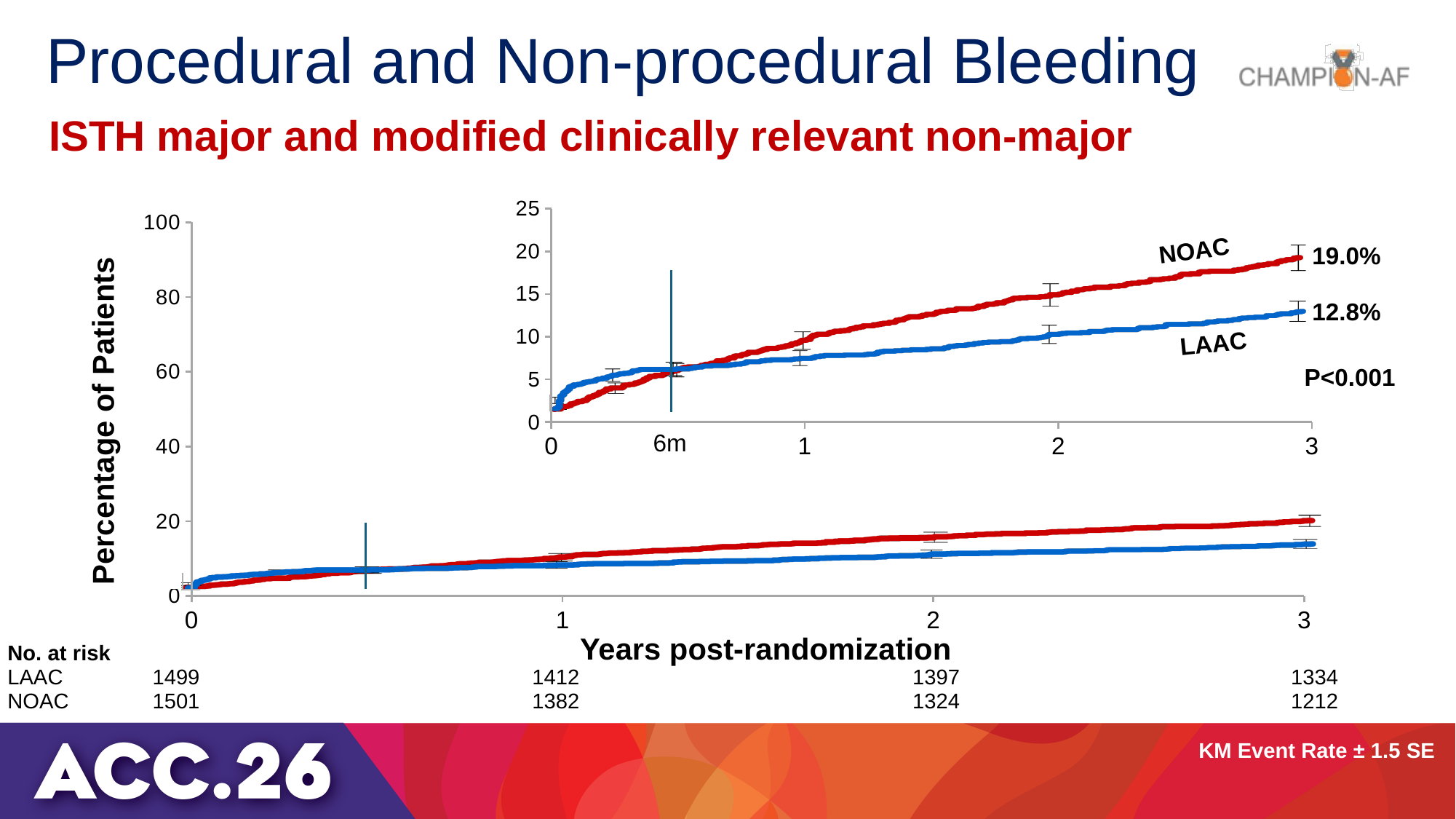
Do the event rates for both groups rise or fall over the years post-randomization? Rise In the inset chart, is the LAAC event rate at 2 years greater or less than 15? less How many NOAC patients were at risk at 1 year? 1382 In the inset chart, is the NOAC event rate at 2 years greater or less than 10? greater What p-value is shown on the chart for the comparison between NOAC and LAAC? P<0.001 Which group has the higher bleeding event rate at 3 years, NOAC or LAAC? NOAC What is the difference between the NOAC and LAAC event rates at 3 years? 6.2 percentage points How many LAAC patients were at risk at 3 years? 1334 How many groups (curves) are plotted on the chart? 2 What is the 3-year event rate for NOAC shown on the inset chart? 19.0% What kind of chart is shown on the slide? Line chart (Kaplan-Meier curve) What is the 3-year event rate for LAAC shown on the inset chart? 12.8%